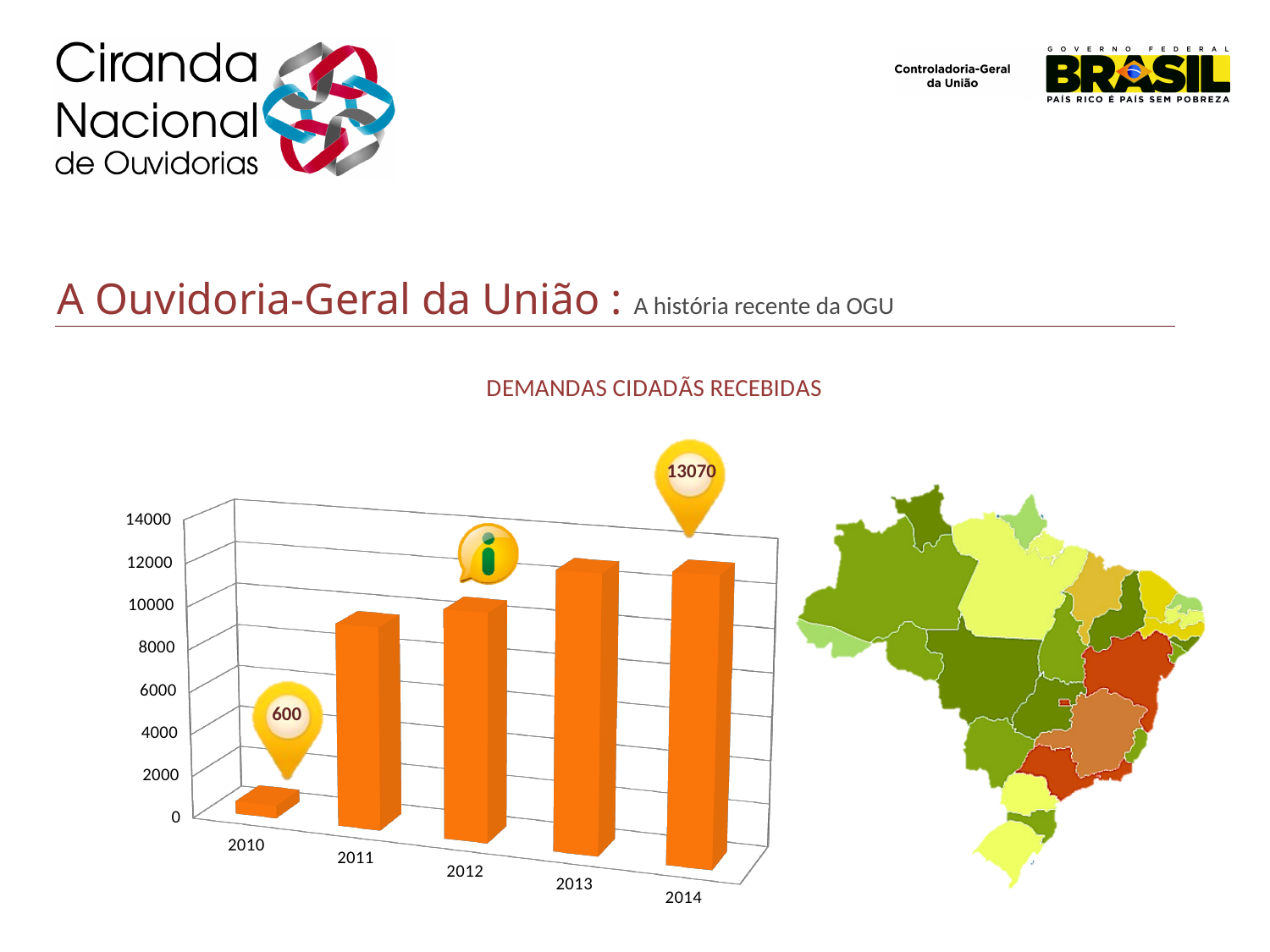
Is the value for 2012 greater or less than 8000? greater What value is shown for 2014 in the DEMANDAS CIDADÃS RECEBIDAS chart? 13070 Which year has the highest number of demands received? 2014 Which year has the lowest number of demands received? 2010 How many years are shown on the x axis of the chart? 5 Which year has a larger value, 2011 or 2013? 2013 Do the values rise or fall from 2010 to 2014? rise What is the title of the chart? DEMANDAS CIDADÃS RECEBIDAS What is the difference between the values for 2014 and 2010? 12470 What value is shown for 2010 in the DEMANDAS CIDADÃS RECEBIDAS chart? 600 What kind of chart is used to show the demands received? bar chart Is the value for 2011 greater or less than 6000? greater